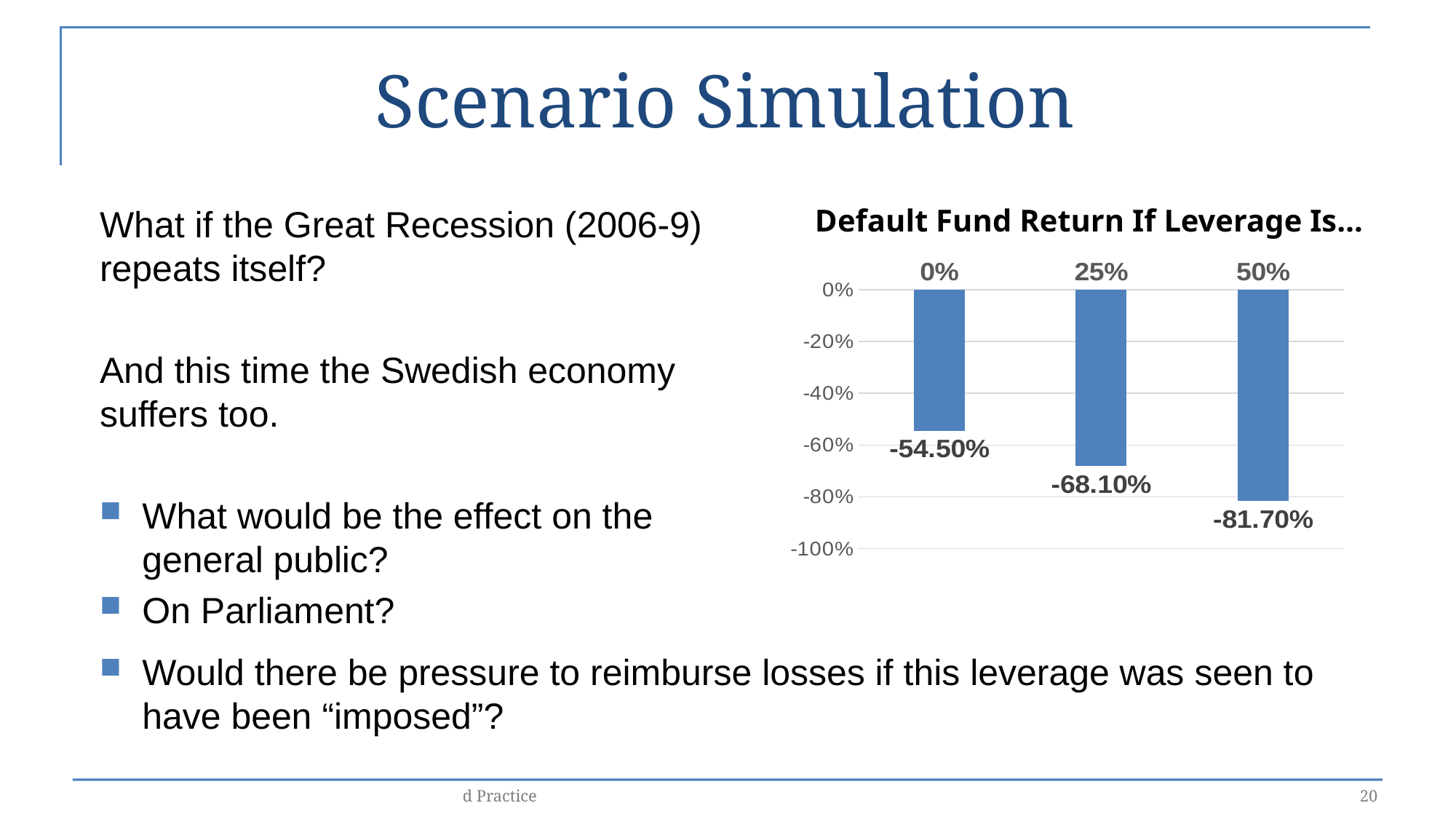
Do the default fund returns rise or fall as leverage increases from 0% to 50%? Fall What is the difference between the default fund return at 0% leverage and at 50% leverage? 27.20 percentage points What is the default fund return when leverage is 25%? -68.10% Which leverage level has the lowest (most negative) default fund return? 50% Which is larger, the default fund return at 0% leverage or at 25% leverage? 0% leverage Which leverage level has the highest (least negative) default fund return? 0% What kind of chart is shown on the slide? Bar chart What is the default fund return when leverage is 0%? -54.50% What is the difference between the default fund return at 25% leverage and at 0% leverage? 13.60 percentage points What is the default fund return when leverage is 50%? -81.70% Is the default fund return at 50% leverage greater or less than -80%? less How many leverage levels are shown in the chart? 3